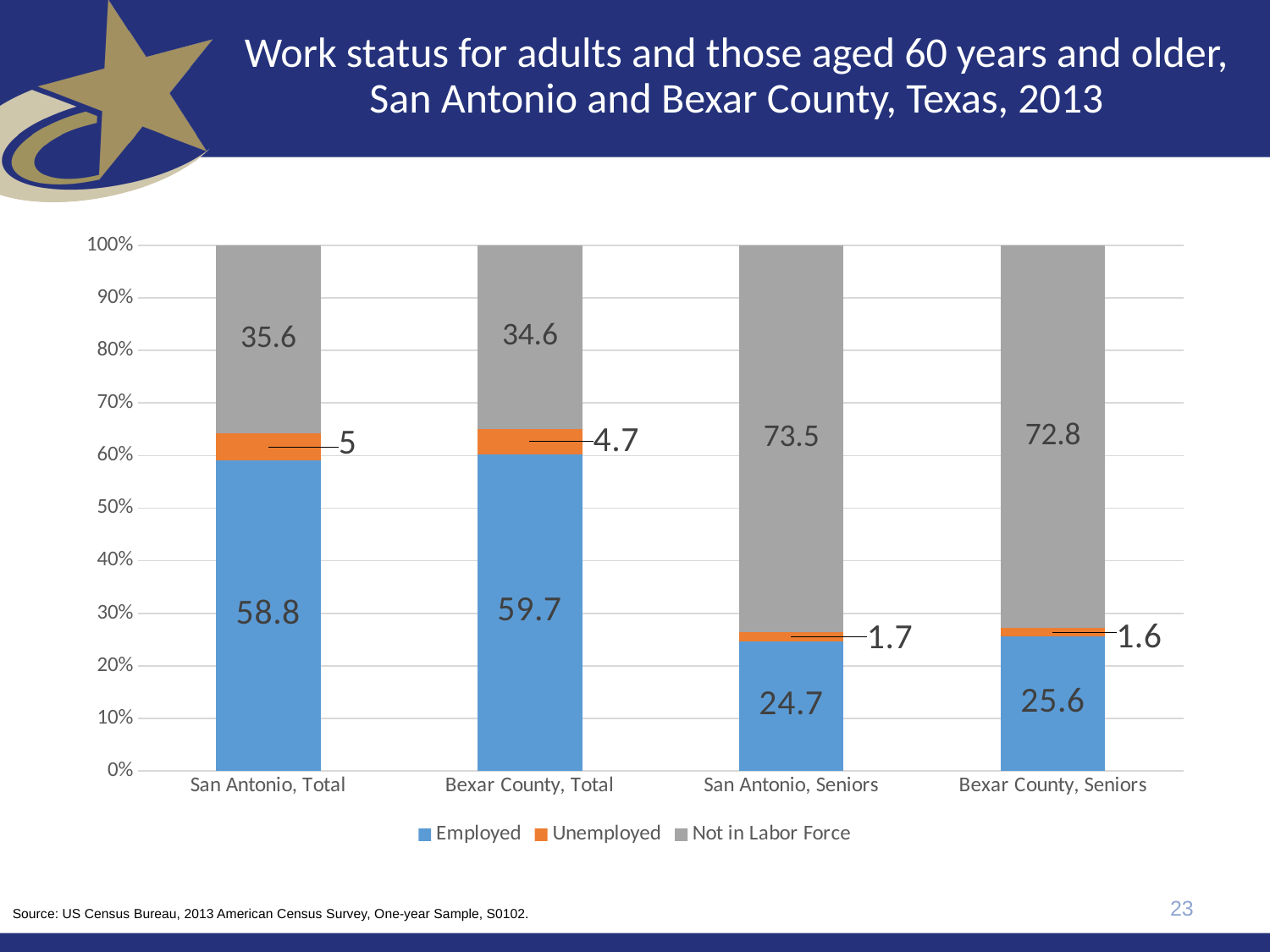
How many categories are shown on the x axis? 4 What is the Employed value for San Antonio, Total? 58.8 What kind of chart is shown on the slide? Stacked bar chart What is the difference between the Not in Labor Force values for San Antonio, Seniors and San Antonio, Total? 37.9 Which category has the lowest Unemployed value? Bexar County, Seniors What is the Not in Labor Force value for Bexar County, Seniors? 72.8 Which colour represents the Not in Labor Force series? Gray Which category has the highest Employed value? Bexar County, Total How many series does the legend list? 3 What is the total of the stacked bar for Bexar County, Total? 99 What is the Unemployed value for San Antonio, Seniors? 1.7 Which is larger, the Employed value for San Antonio, Seniors or for Bexar County, Seniors? Bexar County, Seniors